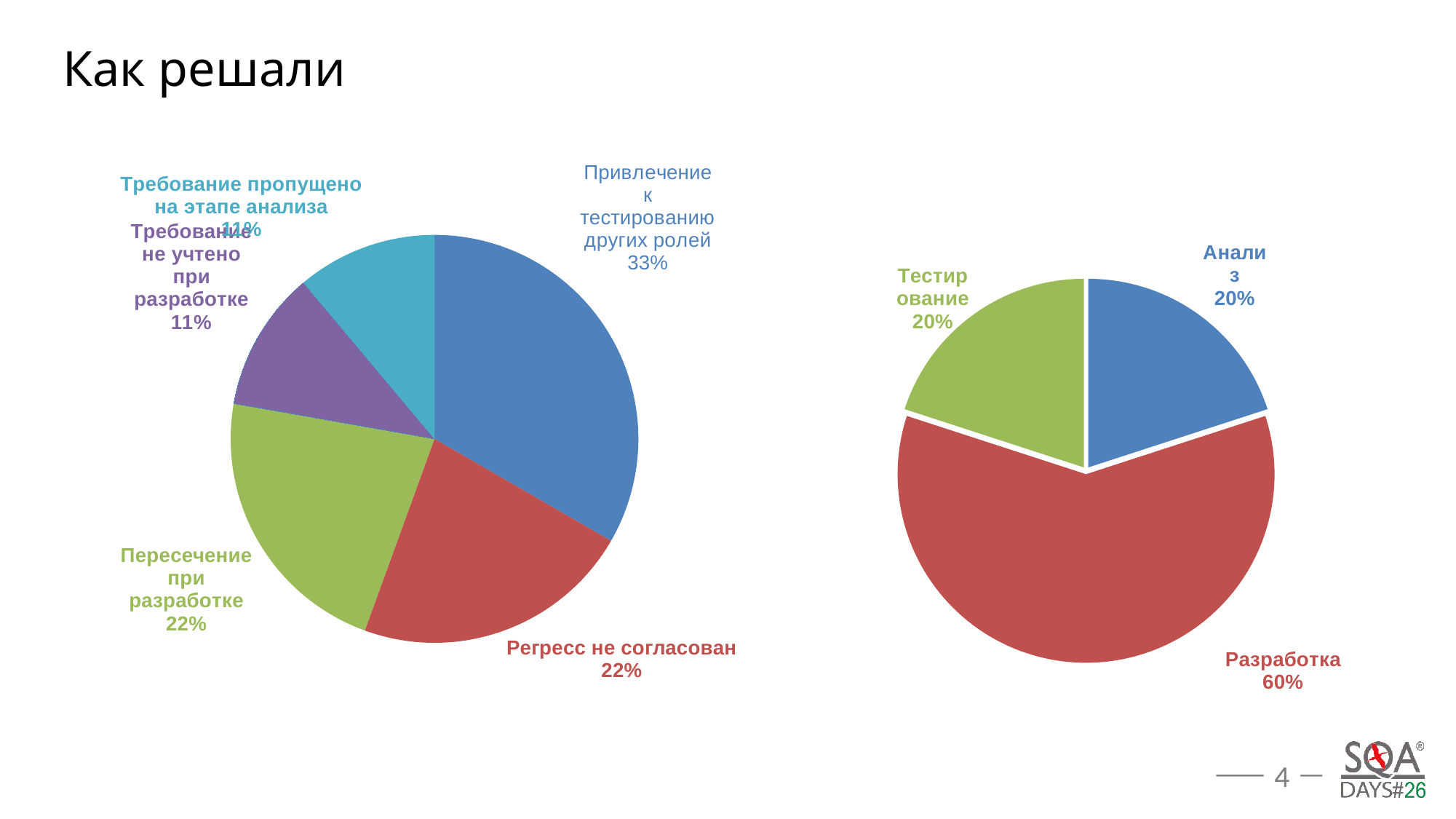
On the left pie chart, which category has the largest slice? Привлечение к тестированию других ролей On the right pie chart, what share is labelled for 'Разработка'? 60% On the right pie chart, which category has the largest slice? Разработка On the right pie chart, what is the difference between the shares of 'Разработка' and 'Анализ'? 40% On the left pie chart, what share is labelled for 'Требование не учтено при разработке'? 11% On the left pie chart, what is the difference between the shares of 'Привлечение к тестированию других ролей' and 'Пересечение при разработке'? 11% On the left pie chart, what share is labelled for 'Регресс не согласован'? 22% How many slices does the left pie chart have? 5 How many slices does the right pie chart have? 3 What type of chart is shown on the right side of the slide? Pie chart On the right pie chart, what share is labelled for 'Тестирование'? 20% On the left pie chart, what share is labelled for 'Привлечение к тестированию других ролей'? 33%